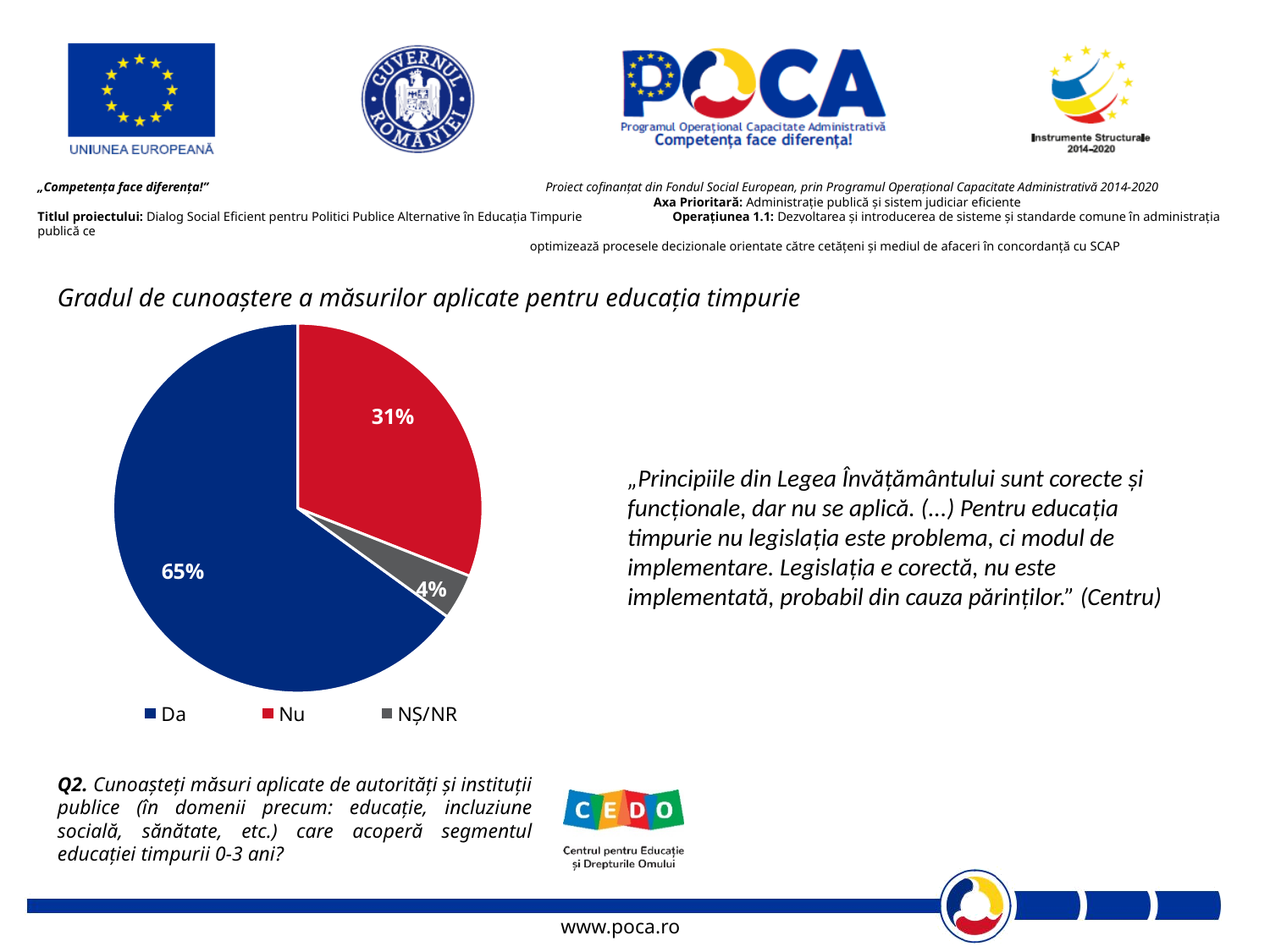
What is the difference in percentage points between the "Da" and "Nu" slices? 34 What share of the pie does "NȘ/NR" represent? 4% What is the title of the chart? Gradul de cunoaștere a măsurilor aplicate pentru educația timpurie Which category has the smallest slice of the pie? NȘ/NR What type of chart is shown on the slide? pie chart Which category has the largest slice of the pie? Da How many categories does the pie chart show? 3 What colour is the "Nu" slice in the pie chart? red What share of the pie does "Da" represent? 65% Which is larger, the "Nu" slice or the "NȘ/NR" slice? Nu What share of the pie does "Nu" represent? 31% What is the combined share of the "Nu" and "NȘ/NR" slices? 35%